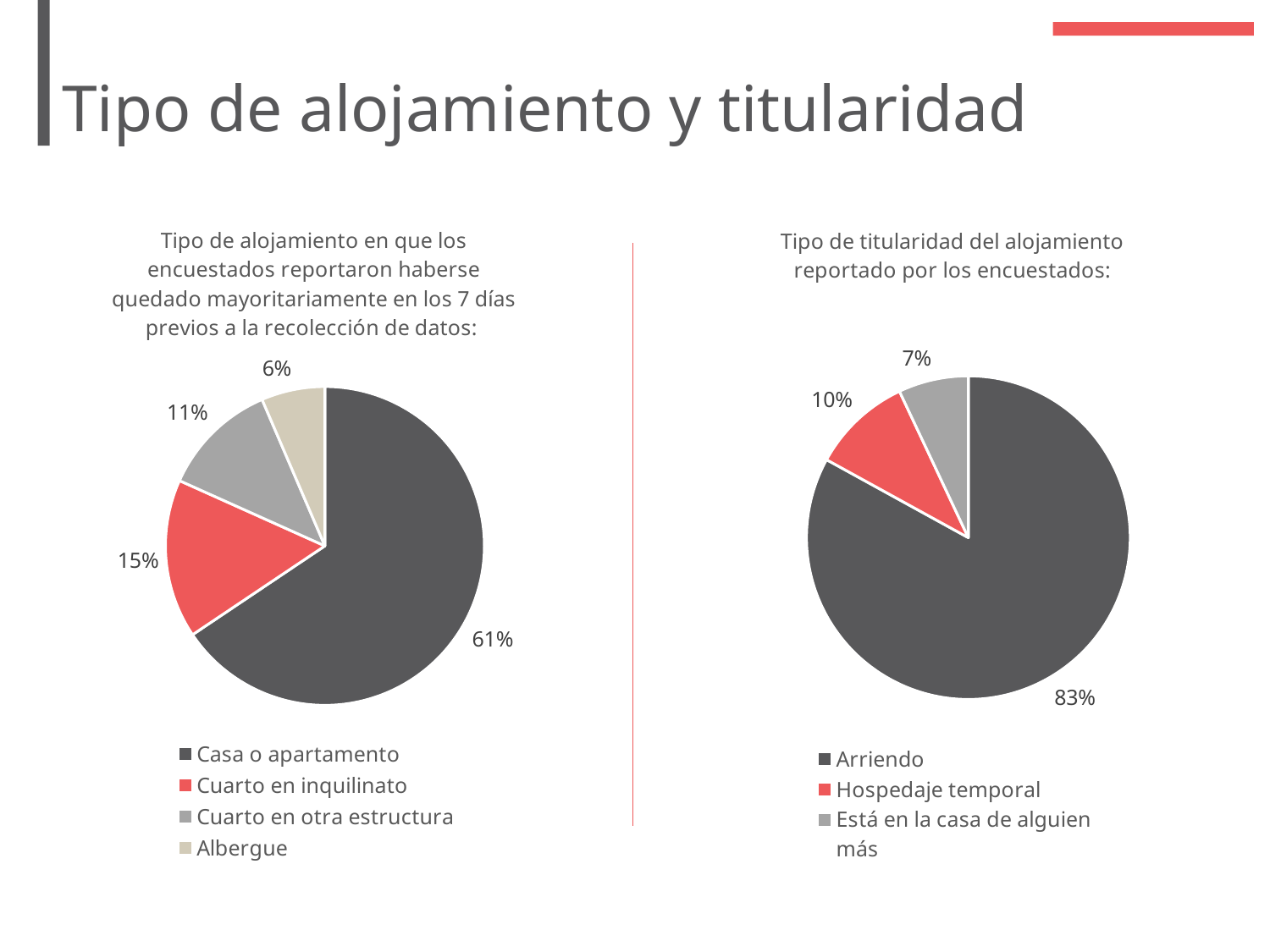
What type of chart is used on the left side of the slide? Pie chart In the right pie chart (Tipo de titularidad), which category has the largest share? Arriendo In the left pie chart (Tipo de alojamiento), what is the difference between Cuarto en inquilinato and Cuarto en otra estructura? 4% In the left pie chart (Tipo de alojamiento), how many categories are shown? 4 In the right pie chart (Tipo de titularidad), what percentage is shown for Hospedaje temporal? 10% In the left pie chart (Tipo de alojamiento), what percentage is shown for Albergue? 6% In the right pie chart (Tipo de titularidad), what percentage is shown for Arriendo? 83% In the left pie chart (Tipo de alojamiento), which category has the smallest share? Albergue In the right pie chart (Tipo de titularidad), how many categories does the legend list? 3 In the left pie chart (Tipo de alojamiento), what percentage is shown for Casa o apartamento? 61% In the left pie chart (Tipo de alojamiento), what percentage is shown for Cuarto en inquilinato? 15% In the right pie chart (Tipo de titularidad), which is larger: Hospedaje temporal or Está en la casa de alguien más? Hospedaje temporal